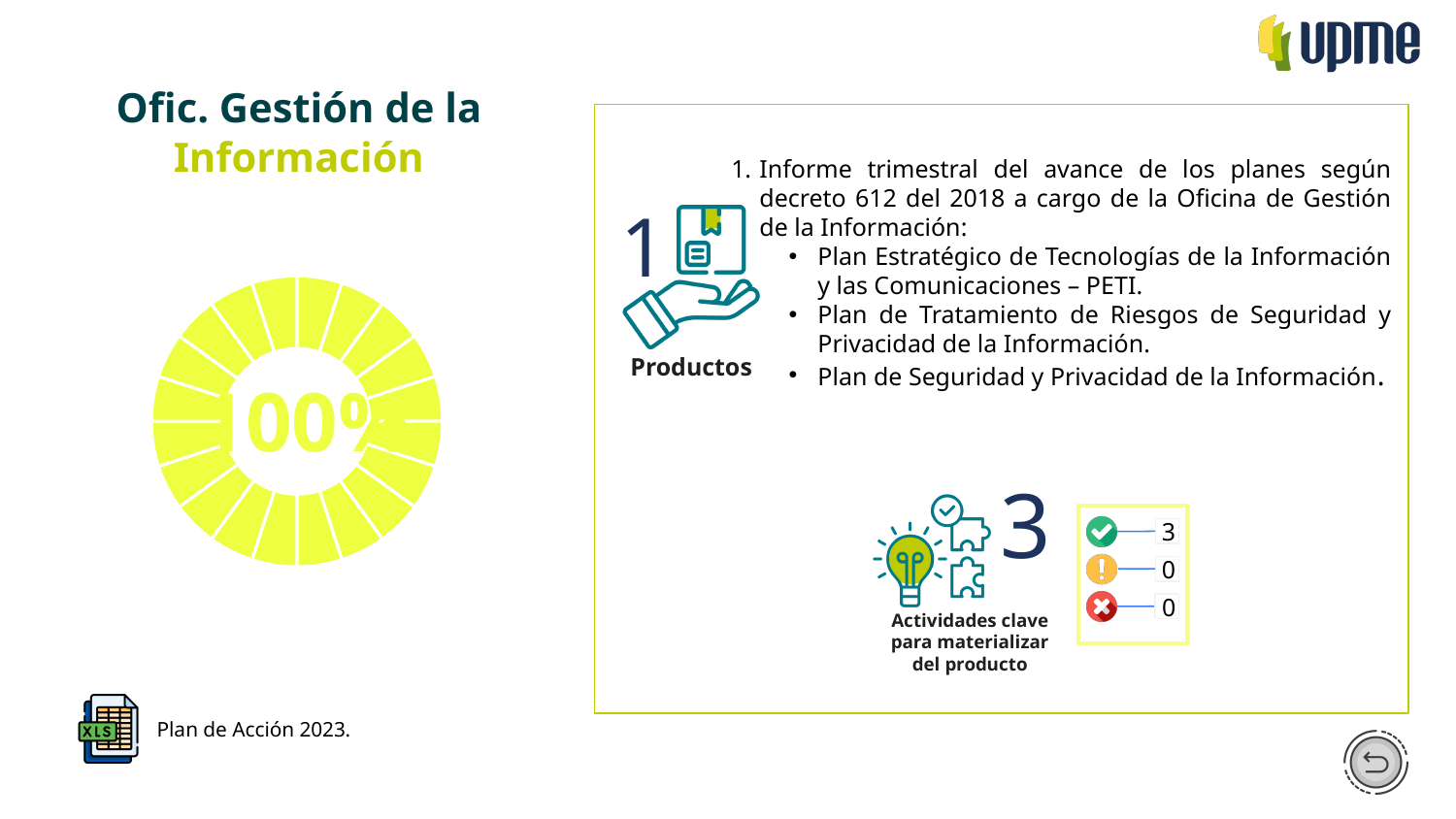
What colour are the segments of the doughnut chart? yellow What value is printed in the centre of the doughnut chart? 00% In the status box next to 'Actividades clave para materializar del producto', what number is shown beside the green check icon? 3 How many 'Productos' are indicated by the large number next to the hand icon? 1 How many 'Actividades clave' are indicated by the large number next to the light bulb icon? 3 In the status box next to 'Actividades clave para materializar del producto', what number is shown beside the yellow exclamation icon? 0 What kind of chart is shown on the left side of the slide? doughnut chart In the status box, which icon has the highest count: green check, yellow exclamation, or red X? green check In the status box next to 'Actividades clave para materializar del producto', what number is shown beside the red X icon? 0 What is the total of the three counts shown in the status box? 3